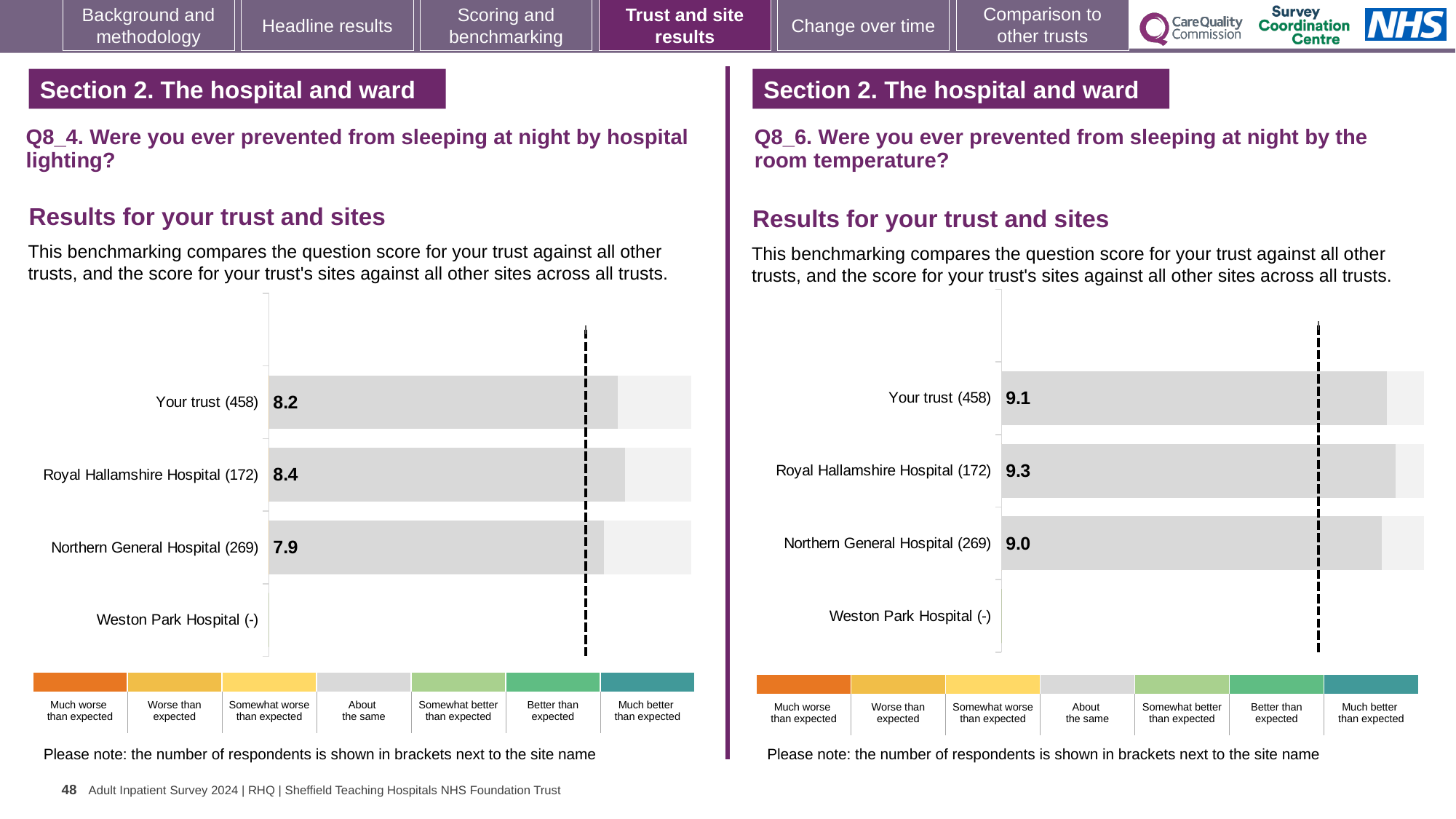
In the Q8_6 chart (room temperature), what is the score for Your trust? 9.1 In the Q8_6 chart (room temperature), which site with a score shown has the lowest score? Northern General Hospital How many rows (sites including Your trust) are listed in the Q8_4 chart (hospital lighting)? 4 In the Q8_6 chart (room temperature), what is the score for Northern General Hospital? 9.0 In the Q8_4 chart (hospital lighting), which site has the highest score? Royal Hallamshire Hospital In the Q8_6 chart (room temperature), is the score for Royal Hallamshire Hospital larger or smaller than the score for Your trust? larger What kind of chart is used for the Q8_6 results (room temperature)? bar chart In the Q8_4 chart (hospital lighting), what is the score for Northern General Hospital? 7.9 In the Q8_4 chart (hospital lighting), what is the score for Royal Hallamshire Hospital? 8.4 In the Q8_4 chart (hospital lighting), what is the score for Your trust? 8.2 In the Q8_4 chart (hospital lighting), what is the difference between the scores for Royal Hallamshire Hospital and Northern General Hospital? 0.5 In the Q8_6 chart (room temperature), what is the score for Royal Hallamshire Hospital? 9.3